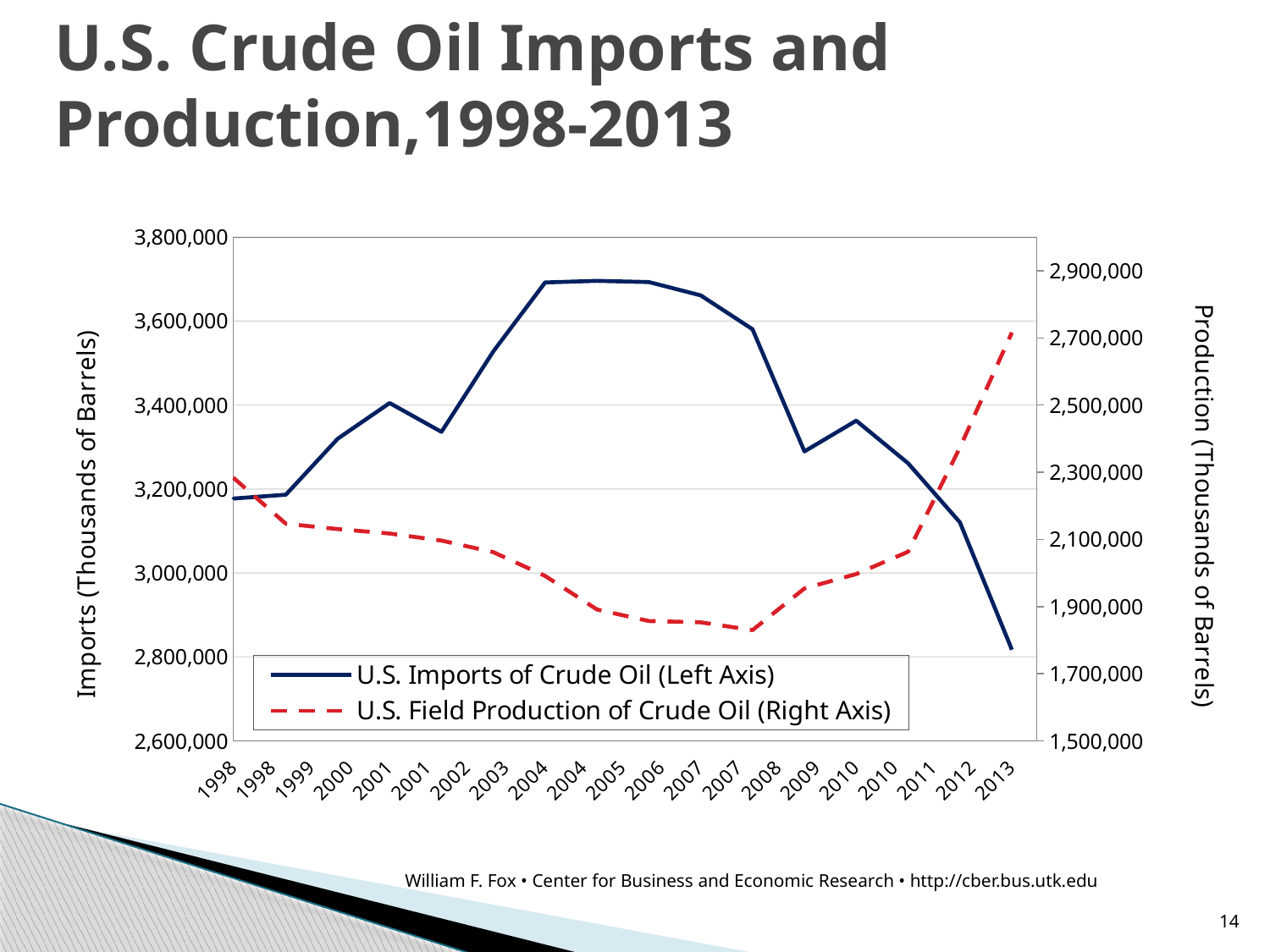
In which year does U.S. Field Production of Crude Oil reach its highest value? 2013 Do U.S. Imports of Crude Oil rise or fall between 2010 and 2013? fall Is the value for U.S. Imports of Crude Oil in 2004 greater or less than 3,600,000? greater In which year do U.S. Imports of Crude Oil reach their lowest value? 2013 Which series is drawn as a red dashed line? U.S. Field Production of Crude Oil (Right Axis) Is the value for U.S. Field Production of Crude Oil in 2013 greater or less than 2,500,000? greater Does U.S. Field Production of Crude Oil rise or fall between 2008 and 2013? rise Is the value for U.S. Imports of Crude Oil in 2013 greater or less than 3,000,000? less What kind of chart is shown on the slide? line chart How many series does the legend list? 2 What is the title of the left vertical axis? Imports (Thousands of Barrels)